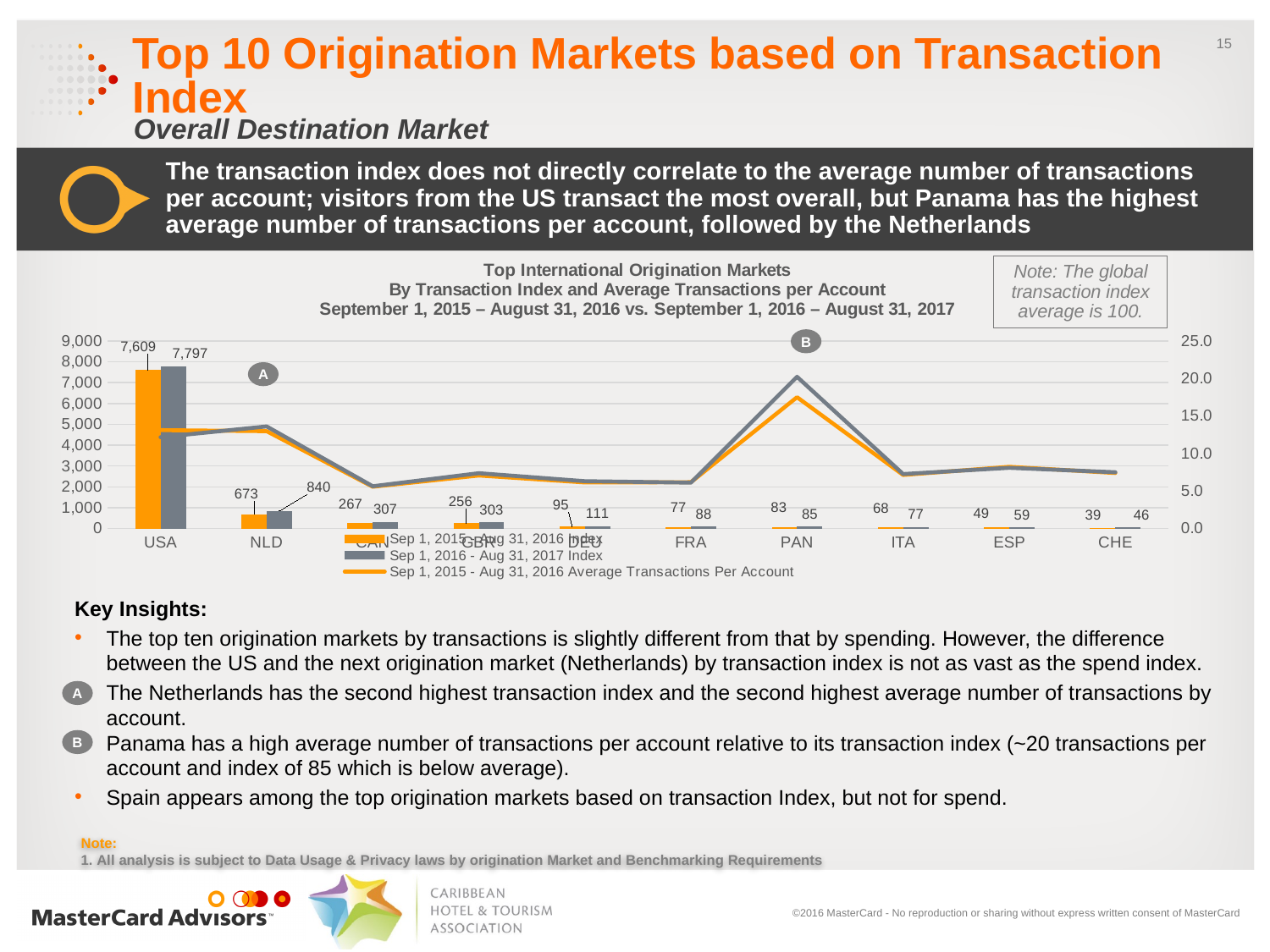
Which market has the lowest Sep 1, 2015 - Aug 31, 2016 Index? CHE By how much did the USA index increase from Sep 1, 2015 - Aug 31, 2016 to Sep 1, 2016 - Aug 31, 2017? 188 Which market has the highest Sep 1, 2016 - Aug 31, 2017 Index? USA What is the difference between the NLD index for Sep 1, 2016 - Aug 31, 2017 and for Sep 1, 2015 - Aug 31, 2016? 167 Which has a higher Sep 1, 2016 - Aug 31, 2017 Index, DEU or FRA? DEU What kind of chart is used to show the transaction index and average transactions per account? Bar and line chart What is the Sep 1, 2016 - Aug 31, 2017 Index value for ESP? 59 What is the Sep 1, 2015 - Aug 31, 2016 Index value for NLD? 673 How many origination markets are shown on the x axis of the chart? 10 According to the note on the chart, what is the global transaction index average? 100 Is the Sep 1, 2015 - Aug 31, 2016 Average Transactions Per Account for PAN greater or less than 15.0? greater What is the Sep 1, 2016 - Aug 31, 2017 Index value for USA? 7,797